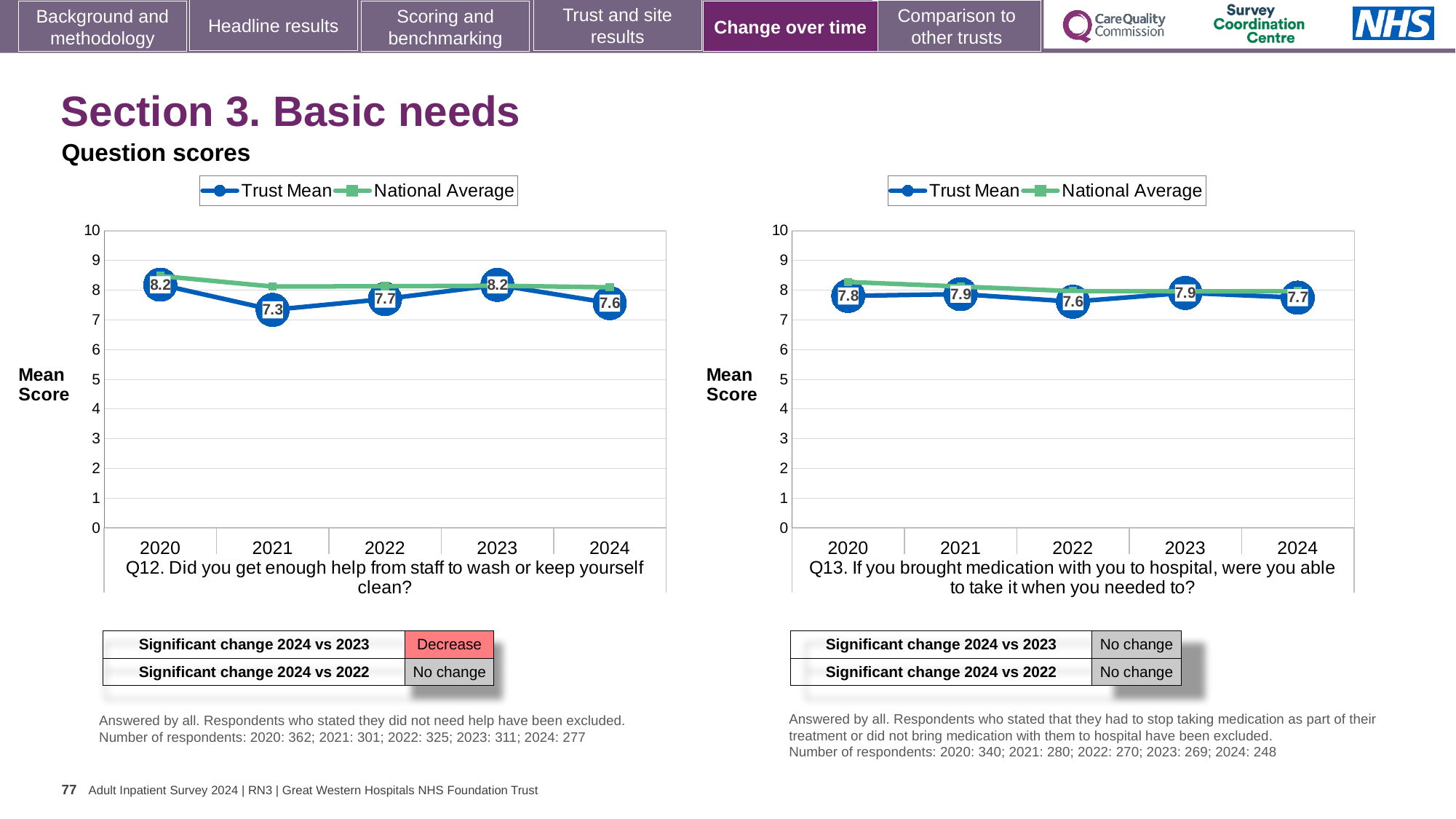
In the Q12 chart on the left, does the Trust Mean score rise or fall from 2023 to 2024? Fall In the Q13 chart on the right, which year has the lowest Trust Mean score? 2022 In the Q12 chart on the left, is the National Average value for 2020 greater or less than 8? greater In the Q12 chart on the left, which year has the higher Trust Mean score, 2023 or 2024? 2023 In the Q12 chart on the left, what is the difference between the Trust Mean scores for 2020 and 2021? 0.9 How many series does the legend of the Q12 chart on the left list? 2 In the Q12 chart on the left, what is the Trust Mean score for 2021? 7.3 How many years are plotted on the x axis of the Q13 chart on the right? 5 What kind of chart is the Q13 chart on the right? Line chart In the Q12 chart on the left, which year has the lowest Trust Mean score? 2021 In the Q13 chart on the right, what is the difference between the Trust Mean scores for 2021 and 2022? 0.3 In the Q13 chart on the right, what is the Trust Mean score for 2022? 7.6